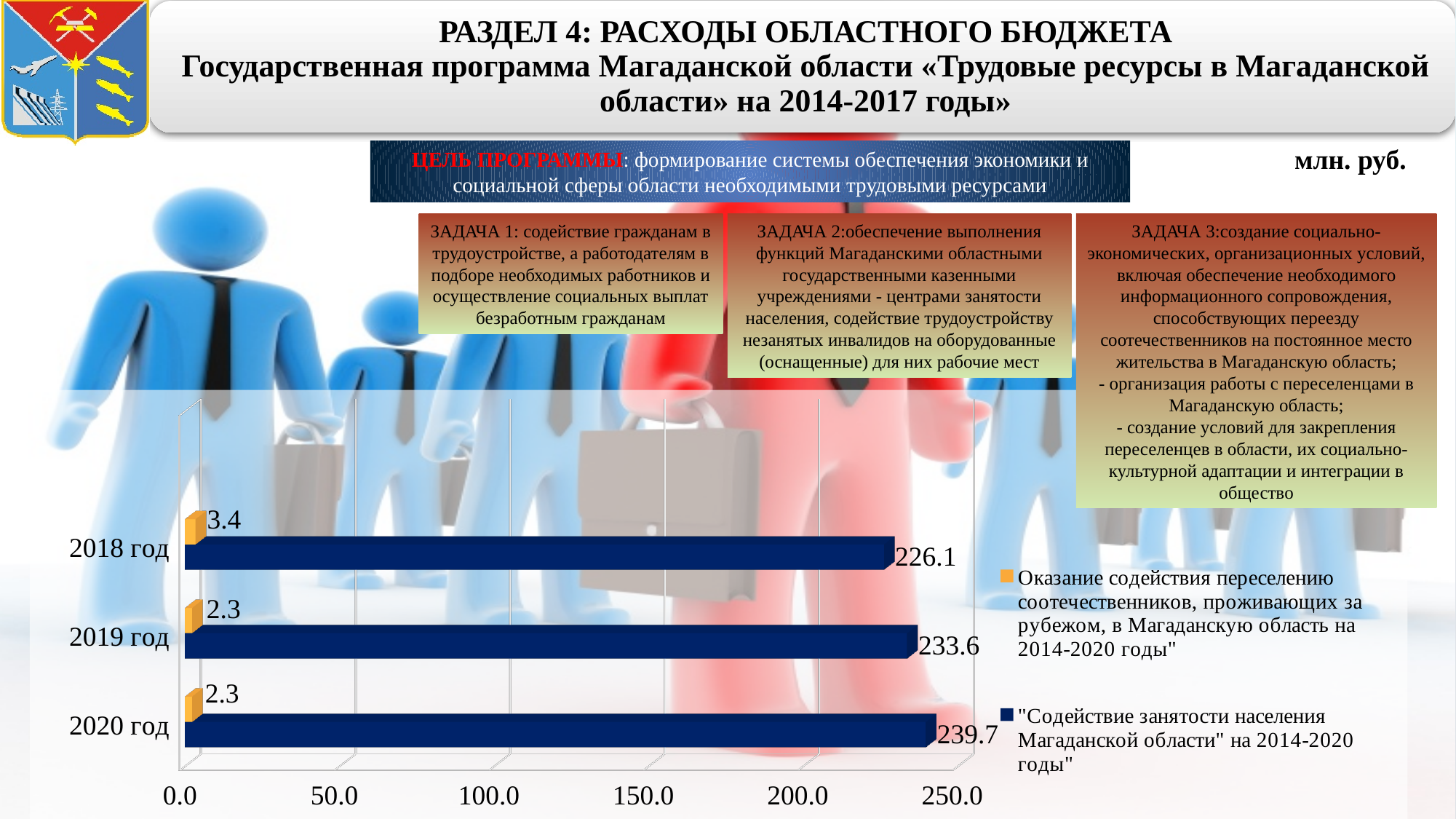
How many years (categories) are shown on the chart? 3 Which is larger: the "Содействие занятости населения" value for 2019 год or for 2018 год? 2019 год What is the value for "Содействие занятости населения Магаданской области" in 2018 год? 226.1 What is the difference between the "Содействие занятости населения" values for 2020 год and 2018 год? 13.6 Which year has the lowest value for "Содействие занятости населения Магаданской области"? 2018 год How many series does the legend list? 2 What is the value for "Оказание содействия переселению соотечественников" in 2019 год? 2.3 What is the value for "Содействие занятости населения Магаданской области" in 2020 год? 239.7 What is the value for "Оказание содействия переселению соотечественников" in 2018 год? 3.4 Do the values for "Содействие занятости населения Магаданской области" rise or fall from 2018 год to 2020 год? rise What type of chart is shown on the slide? bar chart Which year has the highest value for "Содействие занятости населения Магаданской области"? 2020 год